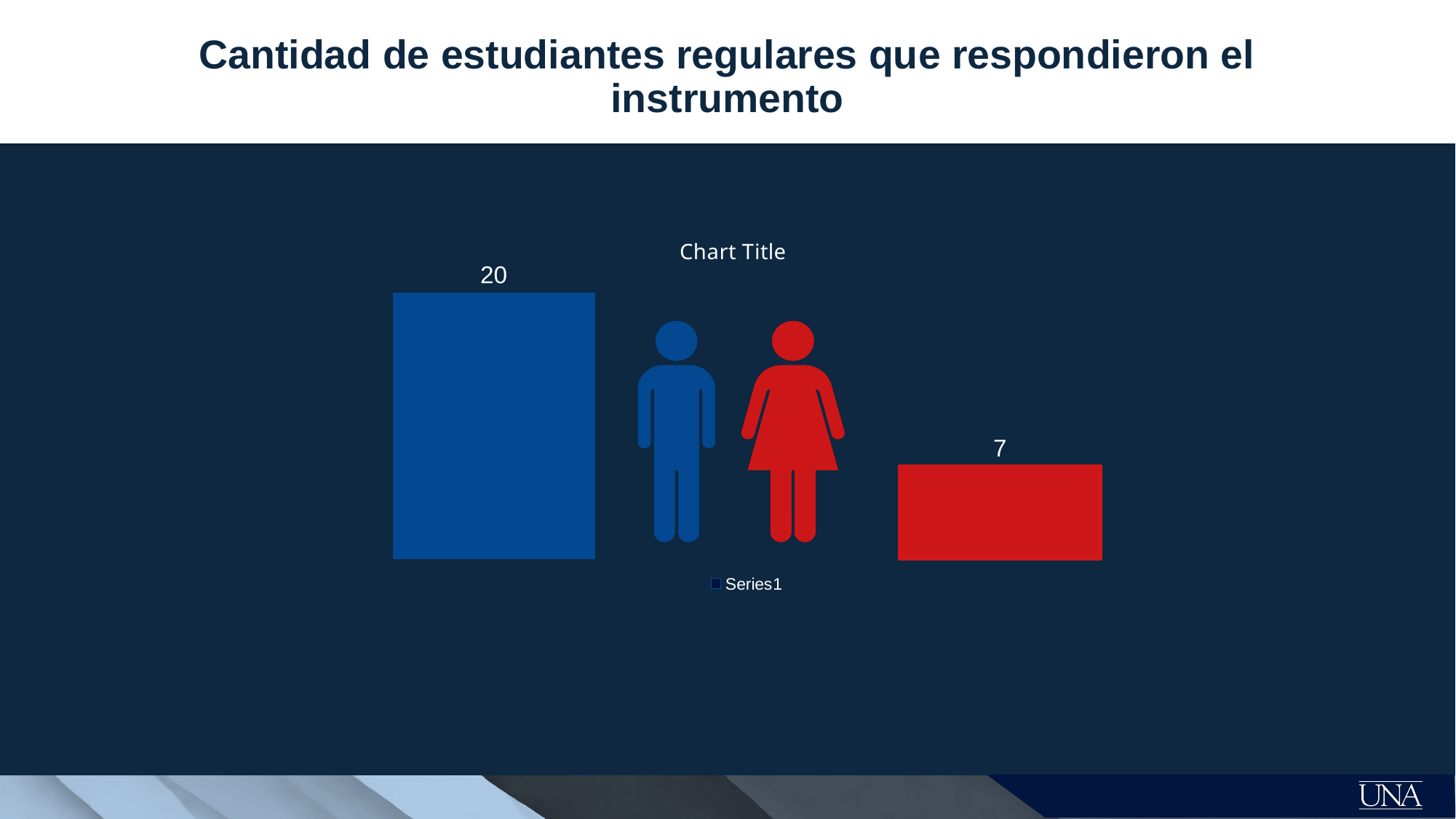
Which bar has the highest value, the blue bar or the red bar? the blue bar What is the difference between the value of the blue bar and the value of the red bar? 13 What is the name of the series shown in the chart legend? Series1 Which bar has the lowest value, the blue bar or the red bar? the red bar Is the value of the red bar larger or smaller than the value of the blue bar? smaller What kind of chart is shown on the slide? bar chart What value is shown on the red bar on the right of the chart? 7 What is the title printed above the chart? Chart Title How many bars are plotted in the chart? 2 How many series does the chart legend list? 1 What value is shown on the blue bar on the left of the chart? 20 What is the total of the two bar values in the chart? 27